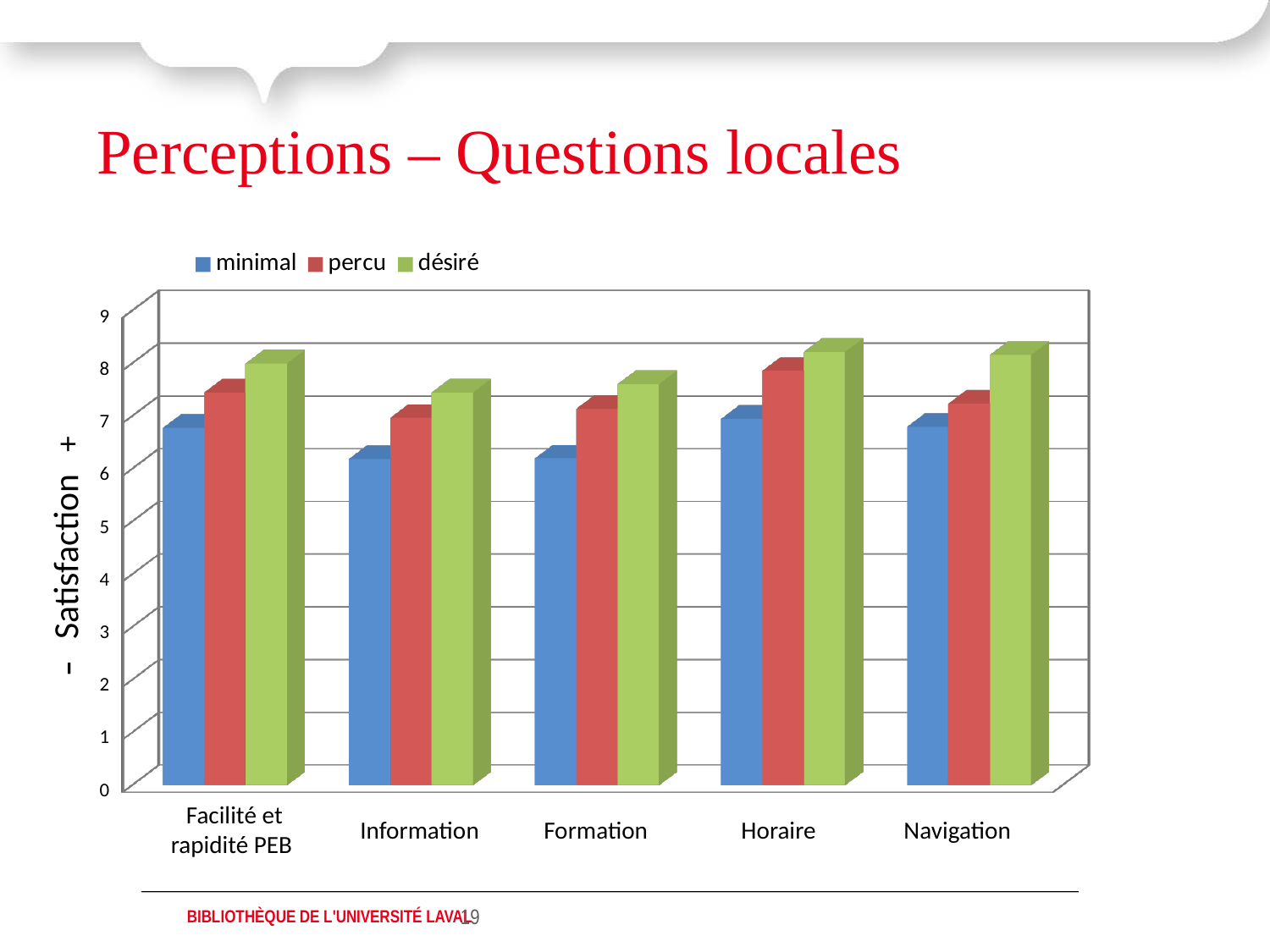
Which category has the highest value for the percu series? Horaire In the Navigation category, which is larger: the minimal value or the désiré value? désiré Is the value for minimal in the Formation category greater or less than 7? less What is the label on the vertical axis? - Satisfaction + Is the value for désiré in the Horaire category greater or less than 7? greater Which is larger: the minimal value for Horaire or the minimal value for Information? Horaire Which series are listed in the legend? minimal, percu, désiré How many series does the legend list? 3 What kind of chart is shown on the slide? bar chart How many categories are shown on the x axis? 5 Is the value for percu in the Facilité et rapidité PEB category greater or less than 5? greater